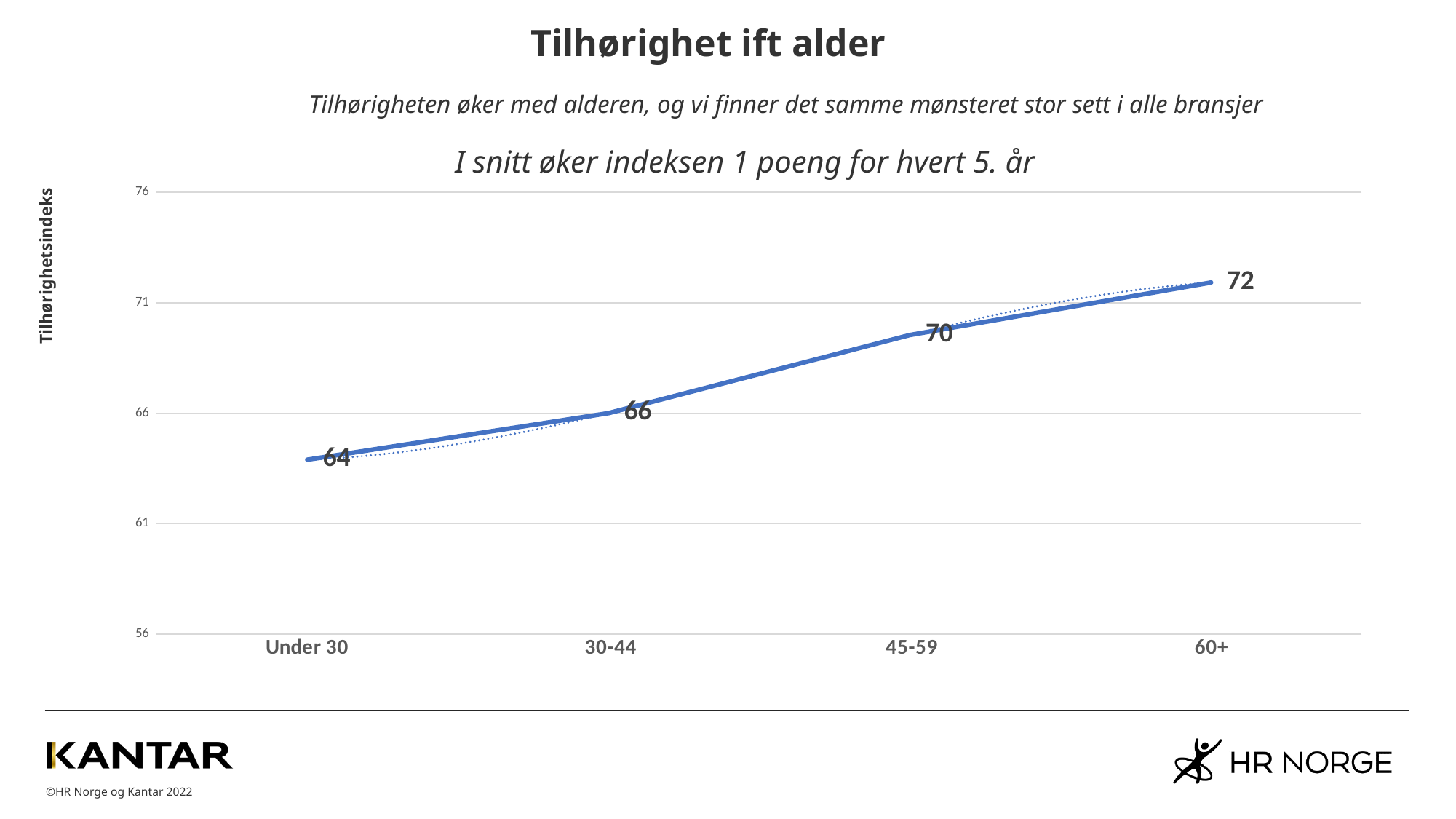
What is the difference in Tilhørighetsindeks between the 60+ and Under 30 age groups? 8 Which age group has the lowest Tilhørighetsindeks? Under 30 Which age group has the highest Tilhørighetsindeks? 60+ Does the Tilhørighetsindeks rise or fall as age increases along the x axis? Rise How many age groups are shown on the x axis? 4 What is the Tilhørighetsindeks value for the 30-44 age group? 66 Which age group has a higher Tilhørighetsindeks, 30-44 or 45-59? 45-59 What is the Tilhørighetsindeks value for the 45-59 age group? 70 What is the Tilhørighetsindeks value for the Under 30 age group? 64 What is the Tilhørighetsindeks value for the 60+ age group? 72 What is the difference in Tilhørighetsindeks between the 45-59 and 30-44 age groups? 4 What kind of chart is shown on the slide? Line chart